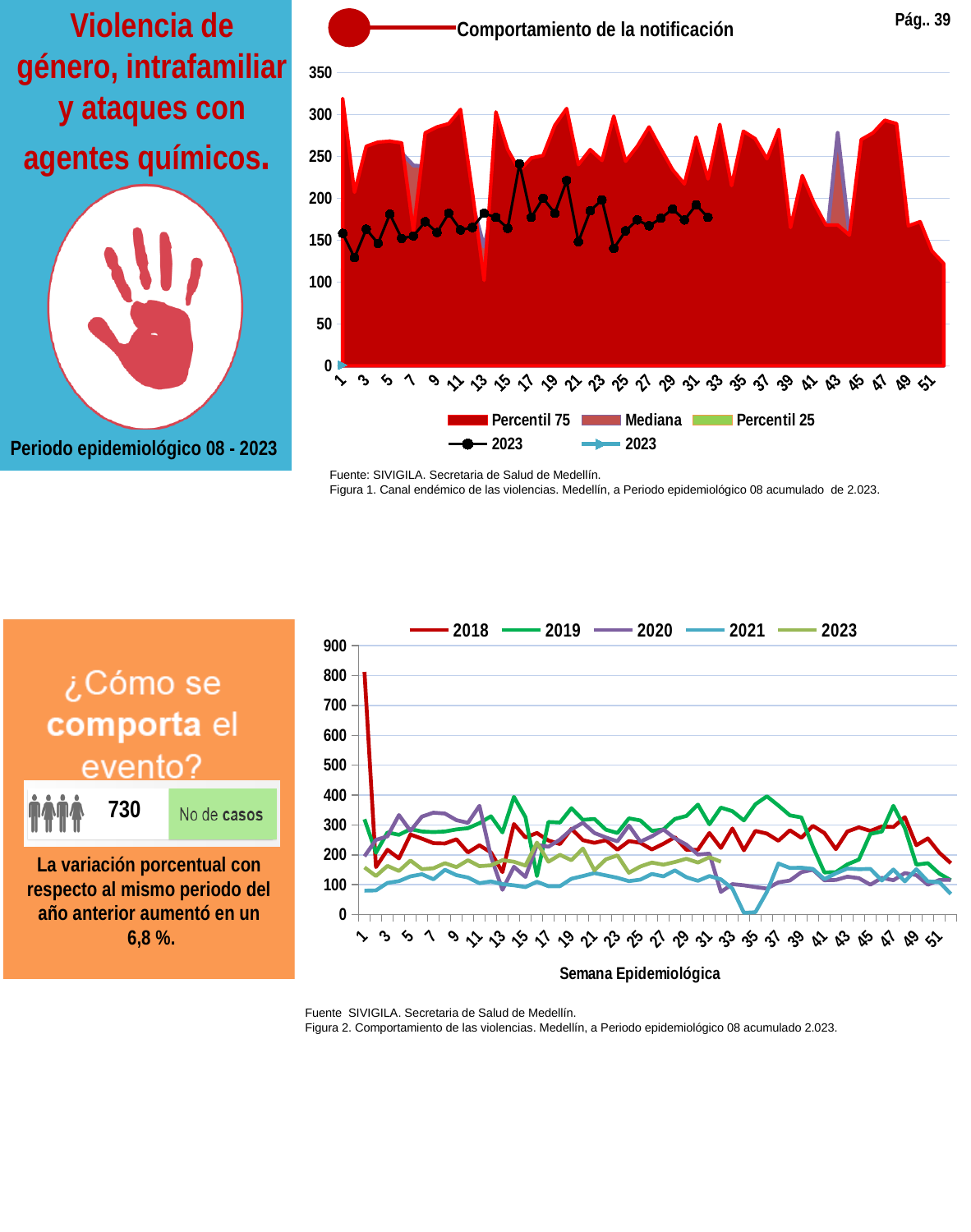
In the top chart titled 'Comportamiento de la notificación', which is larger for the 2023 line, the value at week 2 or the value at week 16? week 16 In the bottom chart, is the value for 2021 at week 35 greater or less than 100? less In the top chart titled 'Comportamiento de la notificación', is the value of the 2023 line at week 16 greater or less than 200? greater In the top chart titled 'Comportamiento de la notificación', how many series does the legend list? 5 In the top chart titled 'Comportamiento de la notificación', is the value of the 2023 line at week 2 greater or less than 150? less In the bottom chart, at week 1, which series has the larger value, 2018 or 2019? 2018 In the bottom chart, what is the title of the x axis? Semana Epidemiológica In the bottom chart, how many series does the legend list? 5 What kind of chart is the bottom chart? Line chart In the bottom chart, which series are listed in the legend? 2018, 2019, 2020, 2021, 2023